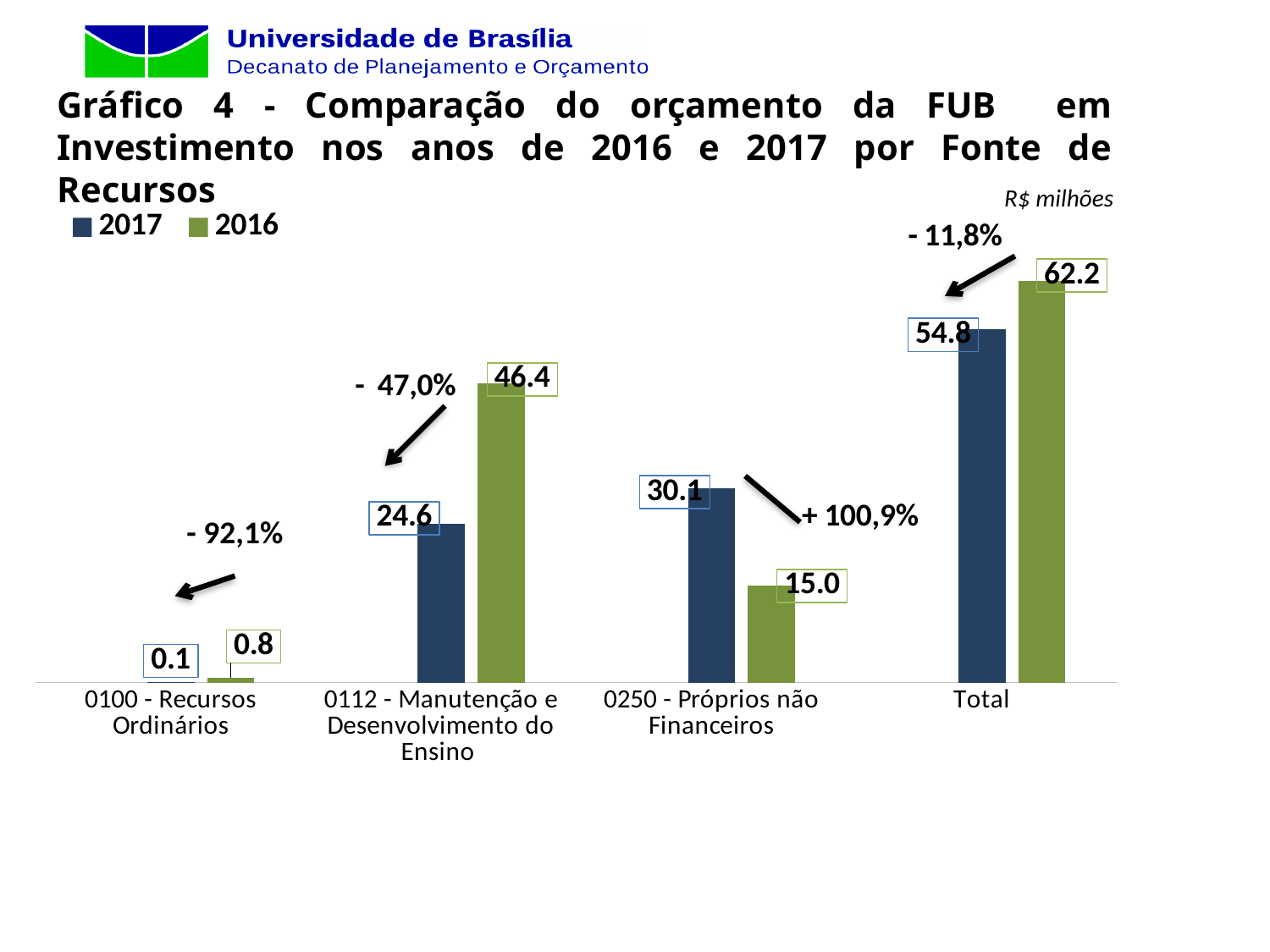
What is the difference between the 2016 and 2017 values for Total? 7.4 How many series does the legend list? 2 For 0112 - Manutenção e Desenvolvimento do Ensino, which year has the larger value, 2016 or 2017? 2016 What is the difference between the 2017 and 2016 values for 0250 - Próprios não Financeiros? 15.1 What is the 2016 value for 0100 - Recursos Ordinários? 0.8 Which category has the lowest 2017 value? 0100 - Recursos Ordinários What kind of chart is shown on the slide? bar chart Excluding Total, which category has the highest 2016 value? 0112 - Manutenção e Desenvolvimento do Ensino What is the 2016 value for 0250 - Próprios não Financeiros? 15.0 How many categories are shown on the x axis? 4 What is the 2017 value for 0112 - Manutenção e Desenvolvimento do Ensino? 24.6 What is the 2017 value for Total? 54.8